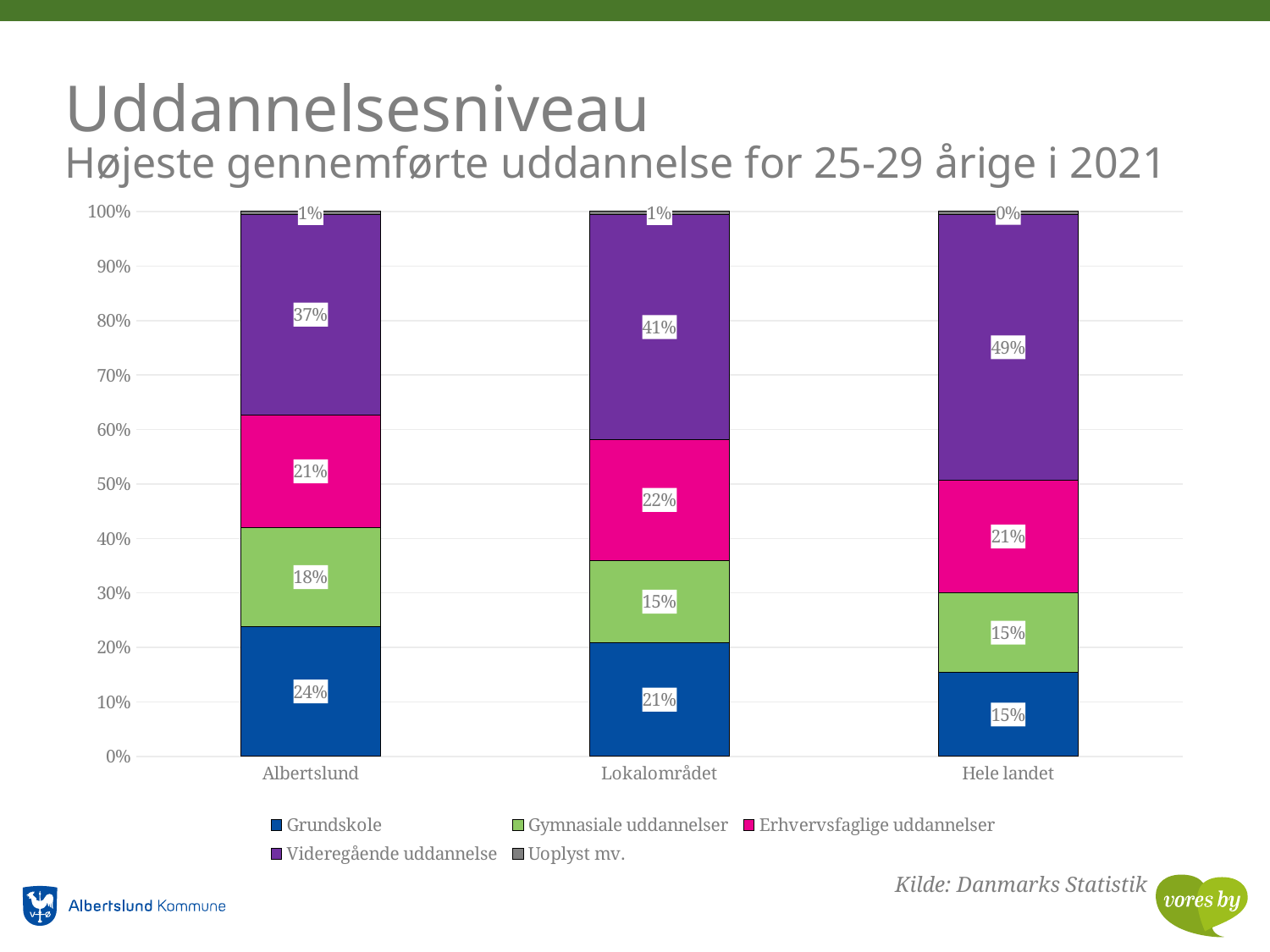
How many series does the legend list? 5 What kind of chart is shown on the slide? Stacked bar chart What is the Uoplyst mv. share for Hele landet? 0% Which category has the lowest Grundskole share? Hele landet How many categories are shown on the x axis? 3 Which is larger: the Grundskole share for Albertslund or for Lokalområdet? Albertslund Which category has the highest Videregående uddannelse share? Hele landet What is the difference between the Videregående uddannelse share for Hele landet and for Albertslund? 12% What is the Grundskole share for Albertslund? 24% What is the Videregående uddannelse share for Hele landet? 49% What is the Gymnasiale uddannelser share for Albertslund? 18% What is the Erhvervsfaglige uddannelser share for Lokalområdet? 22%